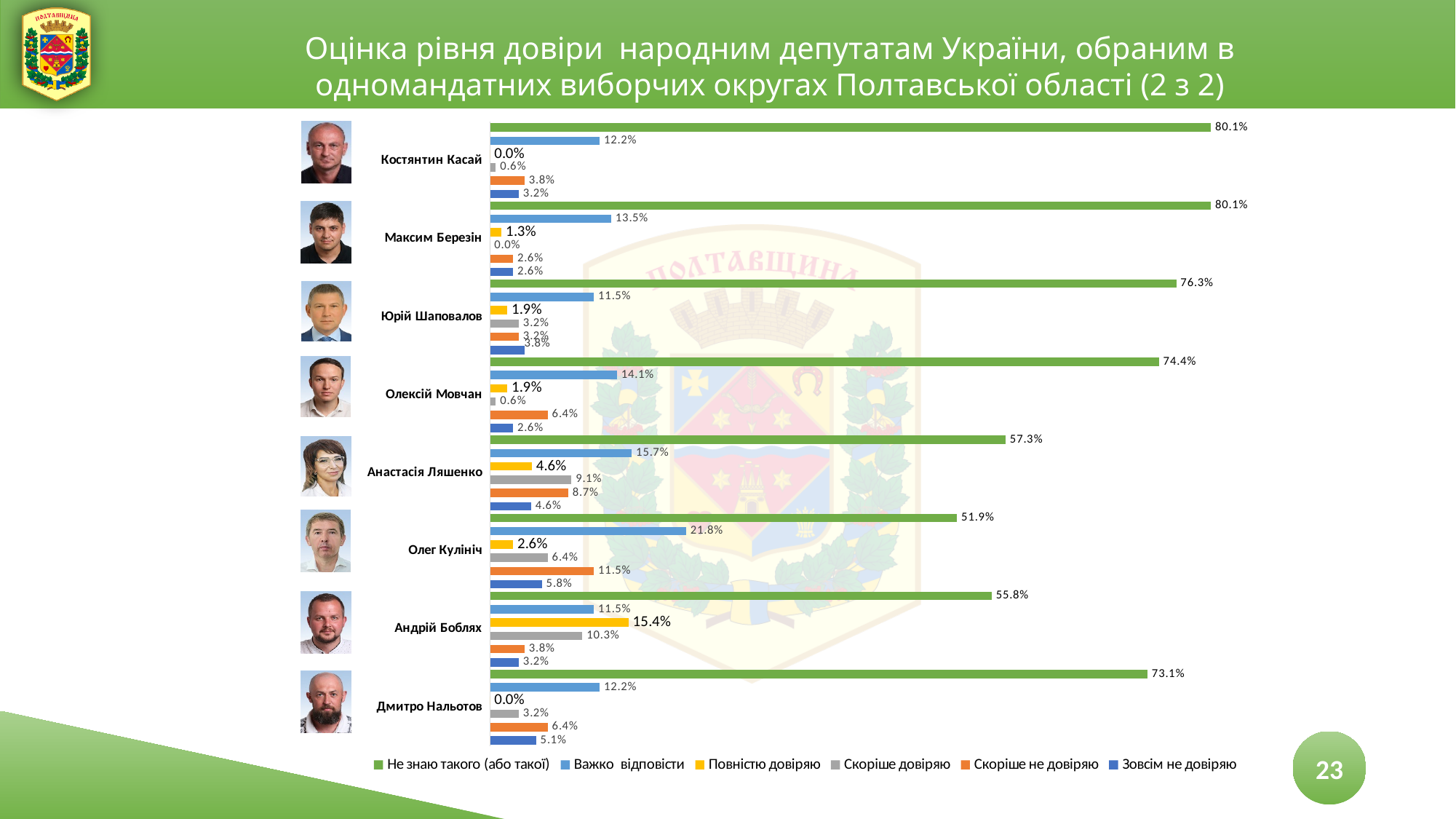
Which is larger: the "Скоріше довіряю" value for Анастасія Ляшенко or for Олег Кулініч? Анастасія Ляшенко What is the "Скоріше не довіряю" value for Анастасія Ляшенко? 8.7% What is the difference between the "Не знаю такого (або такої)" values for Максим Березін and Дмитро Нальотов? 7.0% Which deputy has the highest "Повністю довіряю" value? Андрій Боблях What is the "Важко відповісти" value for Олег Кулініч? 21.8% What percentage of respondents answered "Не знаю такого (або такої)" for Костянтин Касай? 80.1% Which colour represents "Зовсім не довіряю" in the legend? Dark blue Which deputy has the lowest "Не знаю такого (або такої)" value? Олег Кулініч What type of chart is shown on the slide? Bar chart How many deputies are shown in the chart? 8 How many series does the legend list? 6 What is the "Повністю довіряю" value for Андрій Бобляx? 15.4%